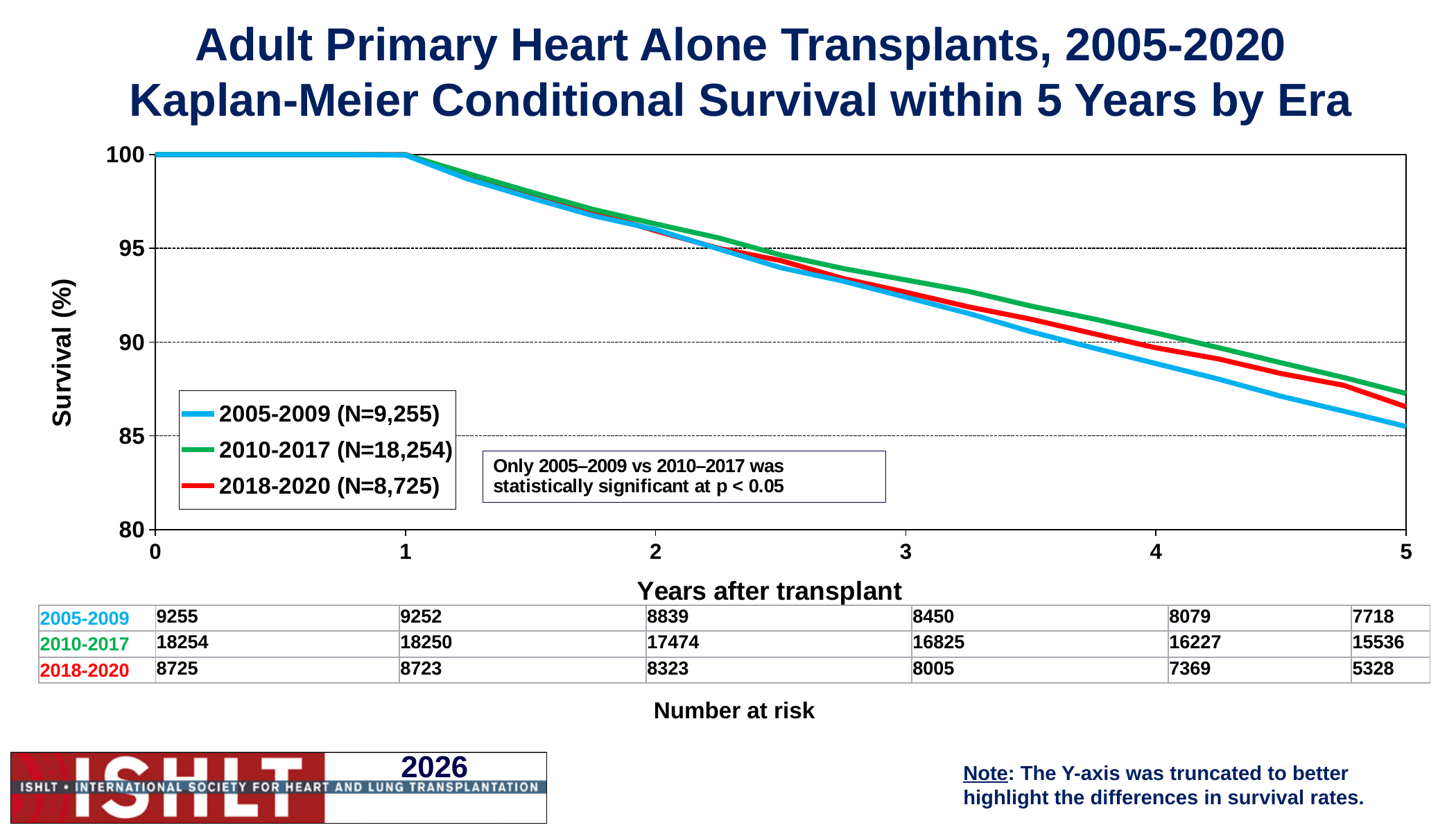
What is the N shown in the legend for the 2010-2017 era? 18,254 According to the number-at-risk table, how many 2018-2020 patients were at risk at year 3? 8005 Is the survival for the 2005-2009 era at year 5 greater or less than 90? less In the number-at-risk table, what is the difference between the 2010-2017 count at year 0 and at year 5? 2718 Do the survival curves rise or fall between year 1 and year 5? fall According to the number-at-risk table, how many 2005-2009 patients were at risk at year 5? 7718 In the number-at-risk table at year 4, which era has more patients at risk: 2005-2009 or 2018-2020? 2005-2009 How many series does the legend list? 3 Is the survival for the 2010-2017 era at year 3 greater or less than 90? greater Which era has the highest survival at year 5? 2010-2017 Which era has the lowest survival at year 5? 2005-2009 What kind of chart is shown on the slide? line chart